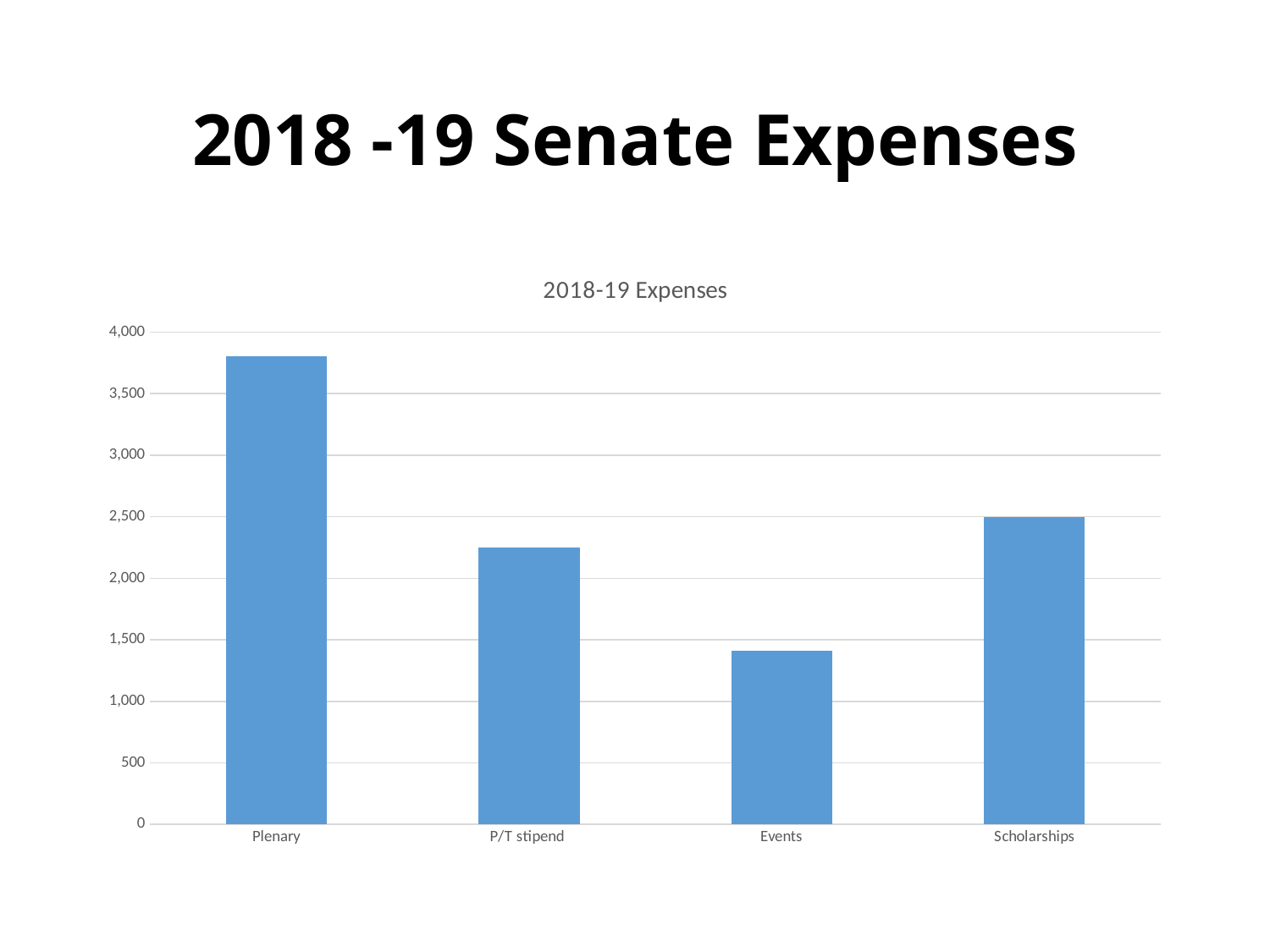
How many categories are shown on the x axis of the chart? 4 Is the value for P/T stipend greater or less than 2,000? greater What is the value for Scholarships in the chart? 2,500 Which is larger, the value for P/T stipend or the value for Scholarships? Scholarships What kind of chart is shown on the slide? bar chart Which category has the highest expense in the chart? Plenary Which is larger, the value for Plenary or the value for Events? Plenary What is the highest value shown on the y axis of the chart? 4,000 Which category has the lowest expense in the chart? Events What is the title of the chart? 2018-19 Expenses Is the value for Plenary greater or less than 3,500? greater Is the value for Events greater or less than 1,500? less